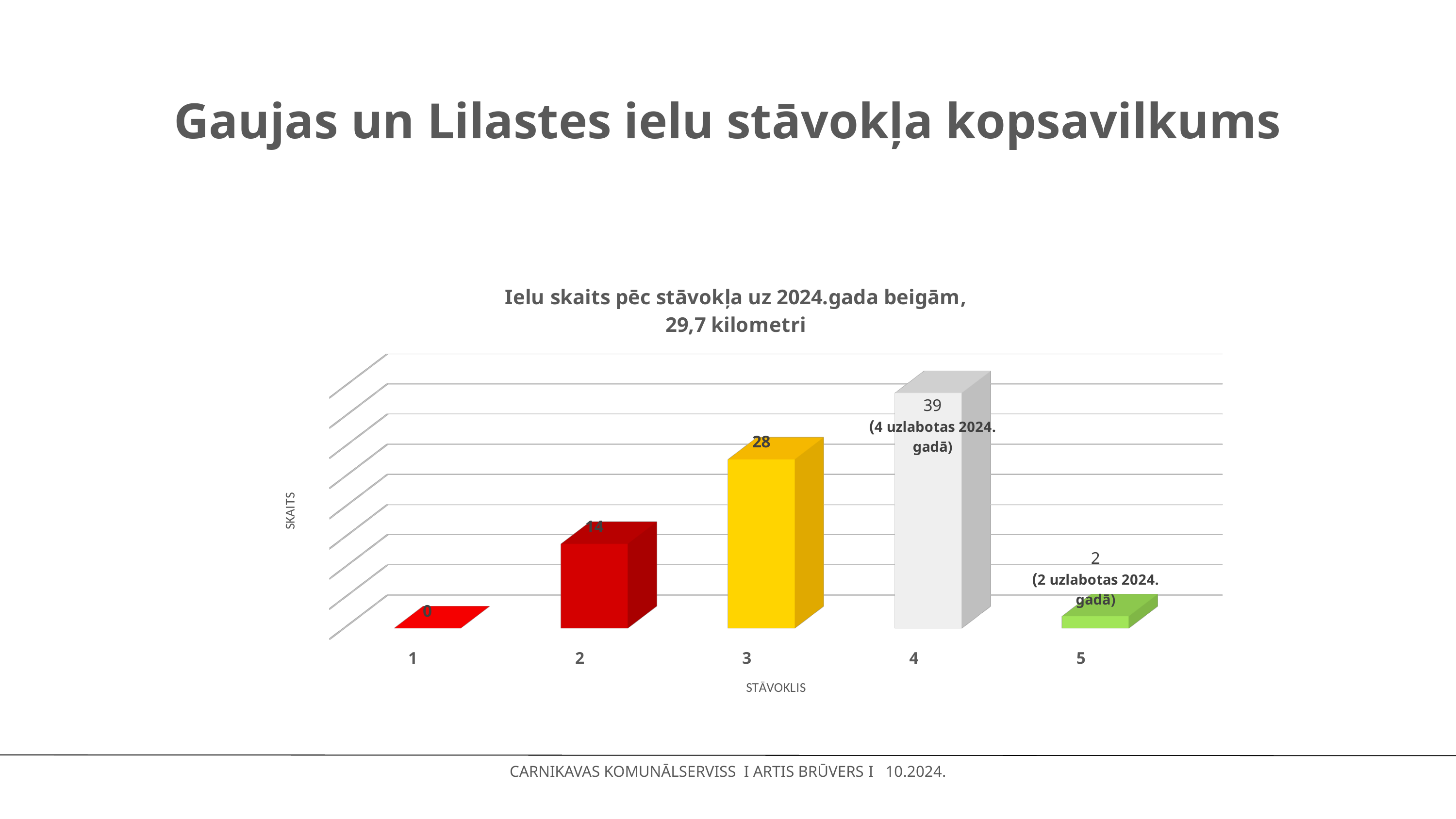
Which is larger, the value for category 2 or the value for category 5? category 2 What is the value for category 5? 2 What is the value for category 1? 0 What is the value for category 3? 28 What is the difference between the values for category 4 and category 3? 11 Which category has the lowest value? 1 What is the title of the chart? Ielu skaits pēc stāvokļa uz 2024.gada beigām, 29,7 kilometri What is the value for category 4? 39 What is the value for category 2? 14 Which category has the highest value? 4 How many categories are shown on the x axis? 5 What kind of chart is shown on the slide? bar chart